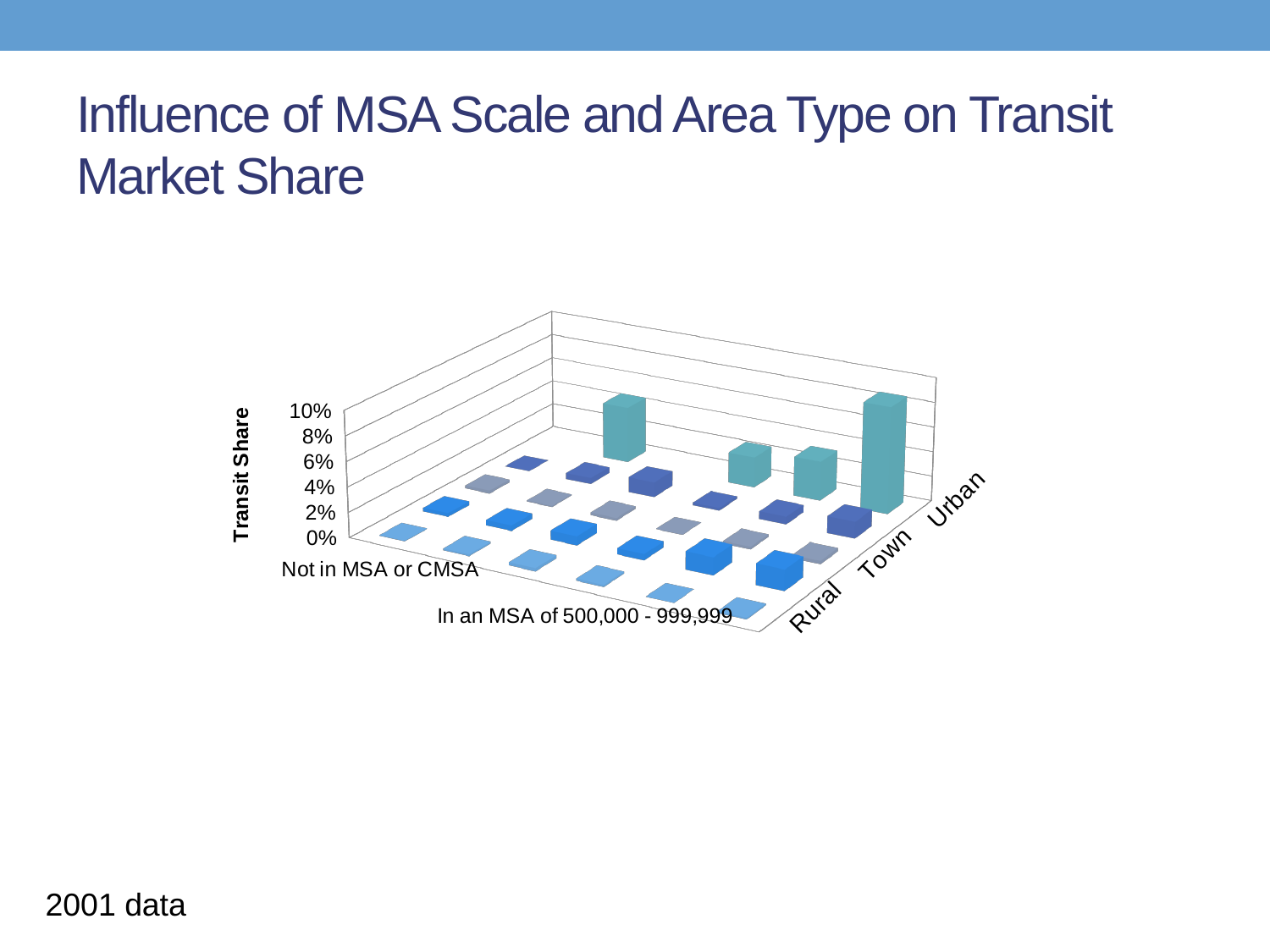
What is the label of the vertical axis of the chart? Transit Share Which area type row contains the tallest bar in the chart? Urban What kind of chart is shown on the slide? bar chart What is the lowest tick value shown on the Transit Share axis? 0% What is the highest tick value shown on the Transit Share axis? 10% Which area type row has the shortest bars overall in the chart? Rural What is the title of the chart on the slide? Influence of MSA Scale and Area Type on Transit Market Share Is the tallest bar in the Urban row greater or less than 4%? greater What year is the data in the chart from, according to the note on the slide? 2001